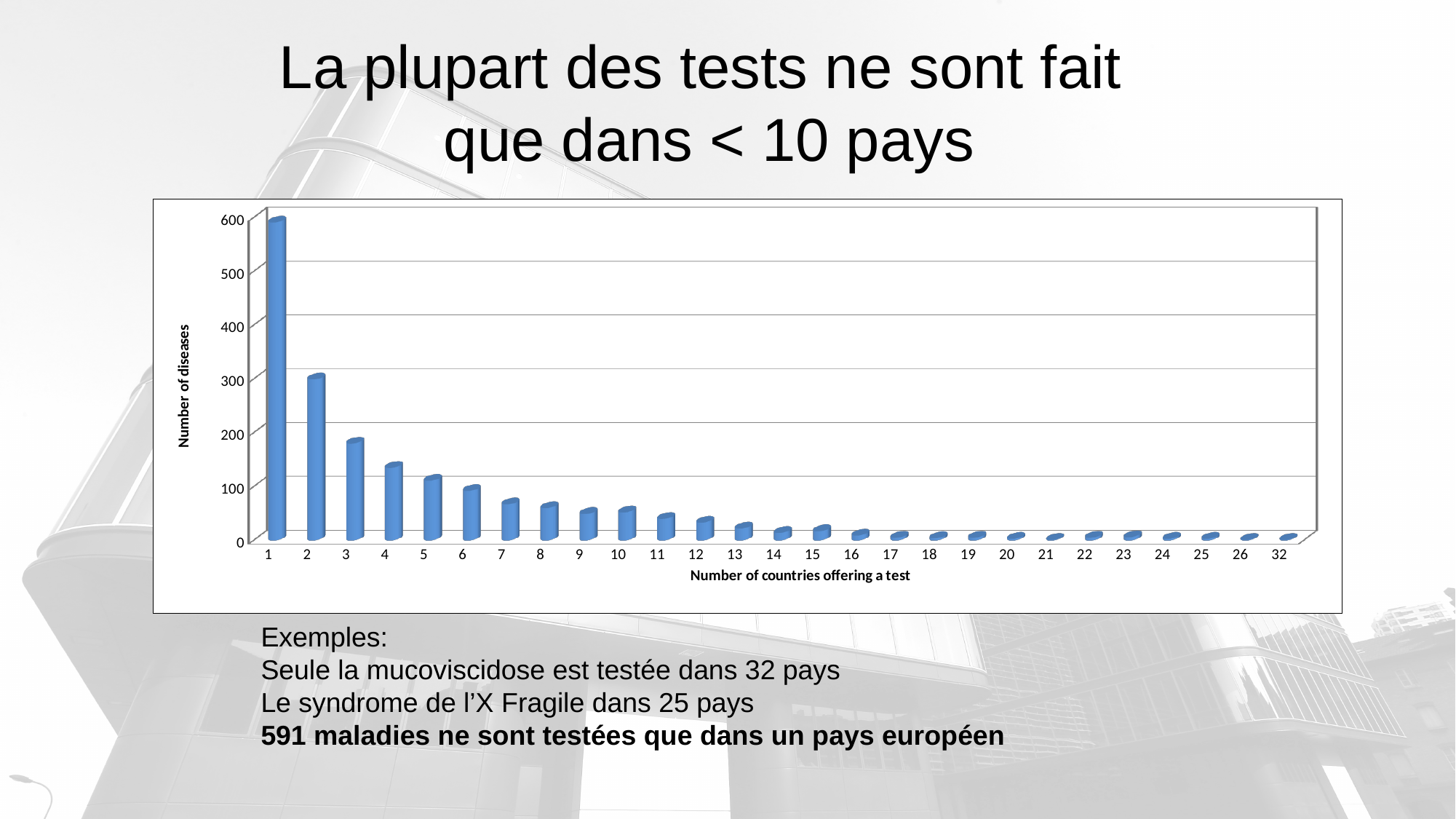
Is the number of diseases for 3 countries offering a test greater or less than 200? less Is the number of diseases for 7 countries offering a test greater or less than 100? less Is the number of diseases for 2 countries offering a test greater or less than 200? greater What kind of chart is shown on the slide? bar chart Which has more diseases: 1 country offering a test or 2 countries offering a test? 1 How many categories are shown on the x axis of the chart? 27 Do the values rise or fall as the number of countries offering a test increases along the x axis? fall What is the title of the vertical axis of the chart? Number of diseases Which number of countries offering a test has the highest number of diseases? 1 Which has more diseases: 3 countries offering a test or 4 countries offering a test? 3